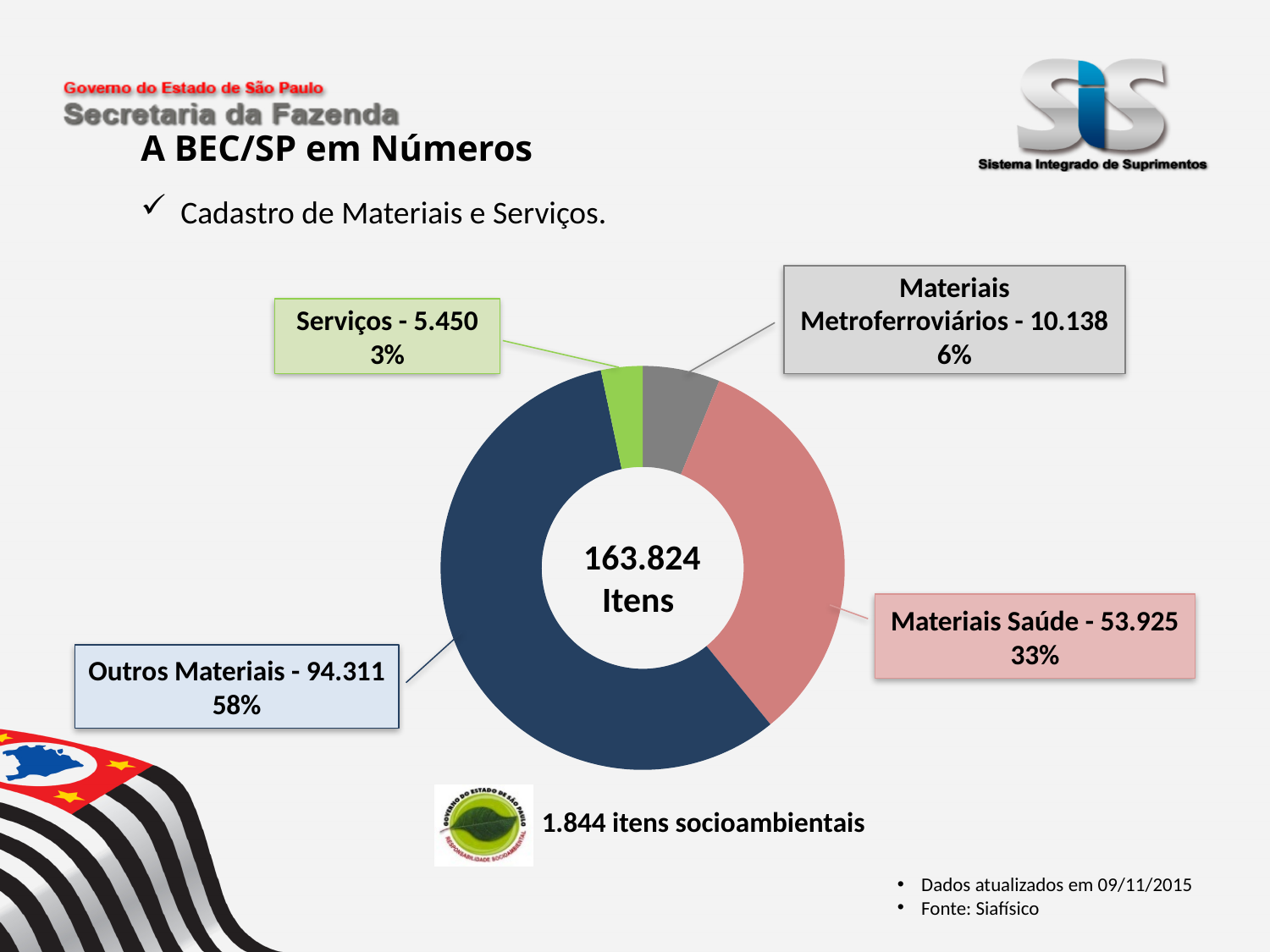
What kind of chart is shown on the slide? Pie chart (donut) What is the value for Serviços? 5.450 Which category has the smallest share of the chart? Serviços What is the value for Materiais Metroferroviários? 10.138 What is the value for Materiais Saúde? 53.925 What is the difference between the values for Outros Materiais and Materiais Saúde? 40.386 Which category has the largest share of the chart? Outros Materiais How many categories does the donut chart show? 4 What share of the chart does Materiais Saúde represent? 33% What total number of items is shown in the centre of the donut chart? 163.824 Itens What is the value for Outros Materiais? 94.311 Which is larger, Materiais Metroferroviários or Serviços? Materiais Metroferroviários